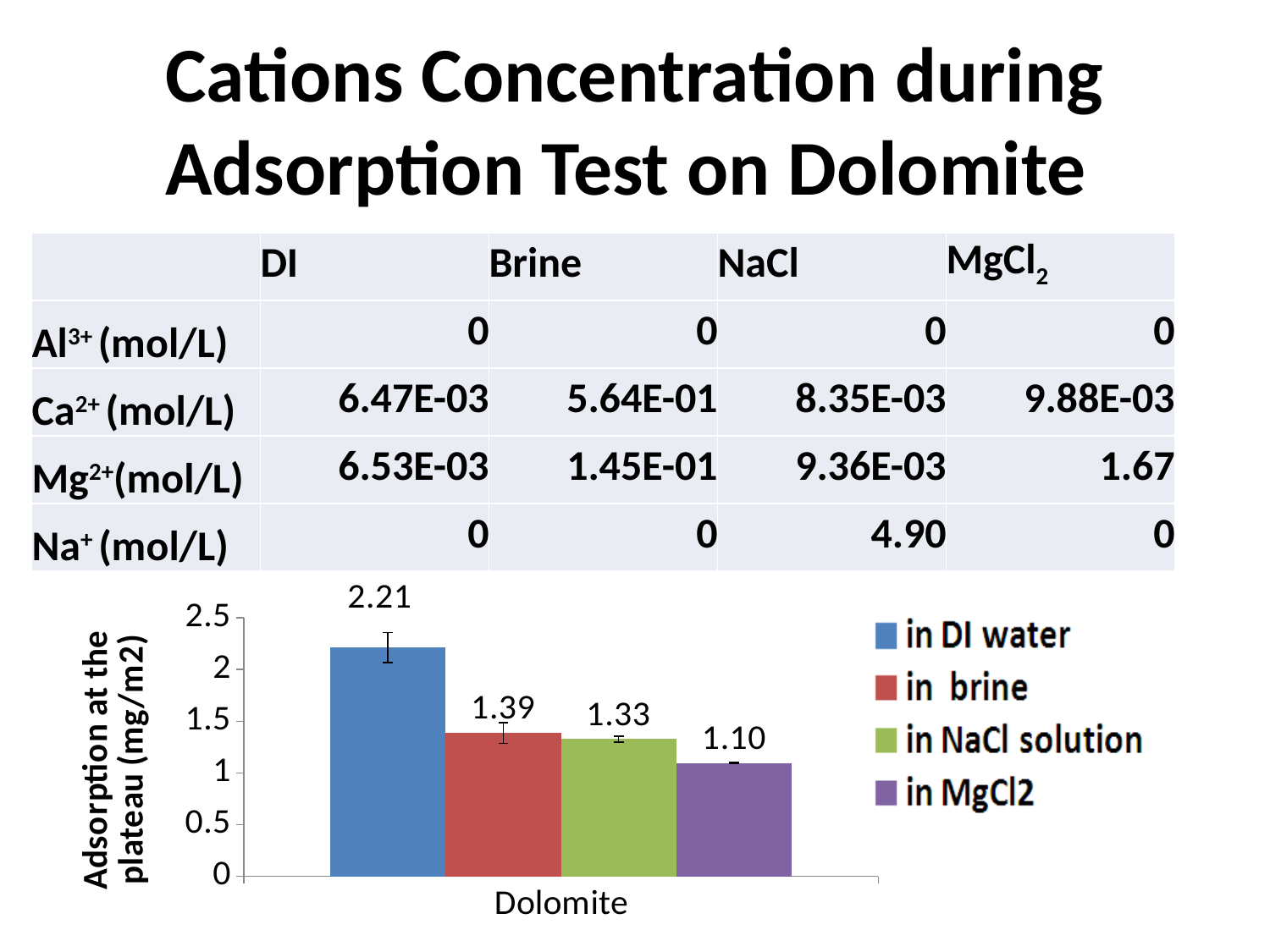
What is the difference between the adsorption in brine and in NaCl solution? 0.06 What is the adsorption at the plateau for dolomite in DI water? 2.21 How many series does the legend list? 4 Which solution gives the lowest adsorption at the plateau on dolomite? in MgCl2 What kind of chart is shown on the slide? bar chart What is the label on the y axis of the chart? Adsorption at the plateau (mg/m2) What is the difference between the adsorption in DI water and in MgCl2? 1.11 What is the adsorption at the plateau for dolomite in NaCl solution? 1.33 What is the adsorption at the plateau for dolomite in MgCl2? 1.10 Is the adsorption in DI water greater or less than 2? greater Which solution gives the highest adsorption at the plateau on dolomite? in DI water What is the adsorption at the plateau for dolomite in brine? 1.39